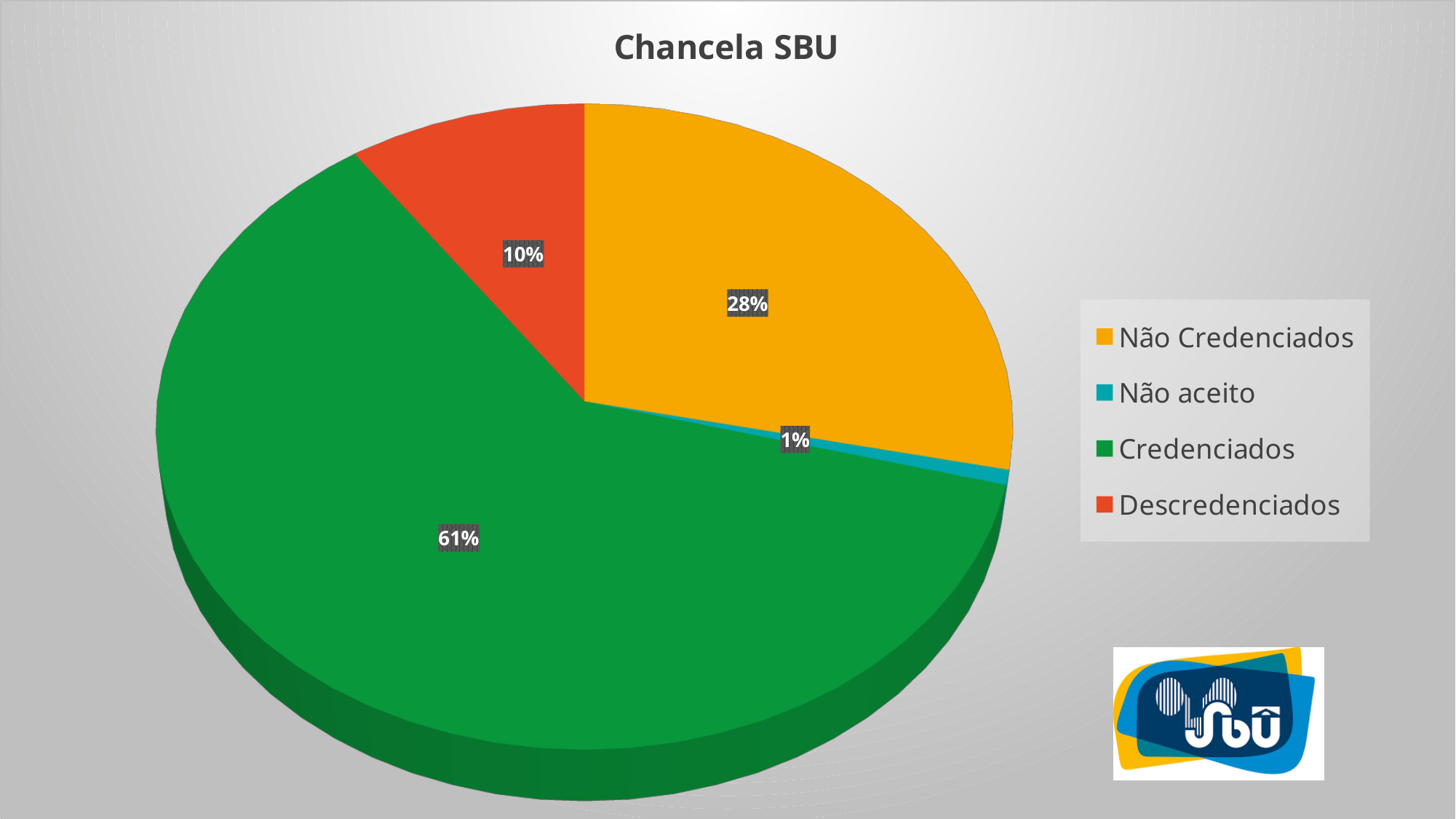
What percentage of the pie is Credenciados? 61% What is the title of the chart? Chancela SBU What percentage of the pie is Não aceito? 1% Which category has the smallest share of the pie? Não aceito How many categories does the legend list? 4 Which category has the largest share of the pie? Credenciados What percentage of the pie is Não Credenciados? 28% Which is larger, the share for Não Credenciados or the share for Descredenciados? Não Credenciados What colour represents Descredenciados in the chart? Red What is the difference in percentage points between Credenciados and Não Credenciados? 33 What type of chart is shown on the slide? Pie chart What percentage of the pie is Descredenciados? 10%